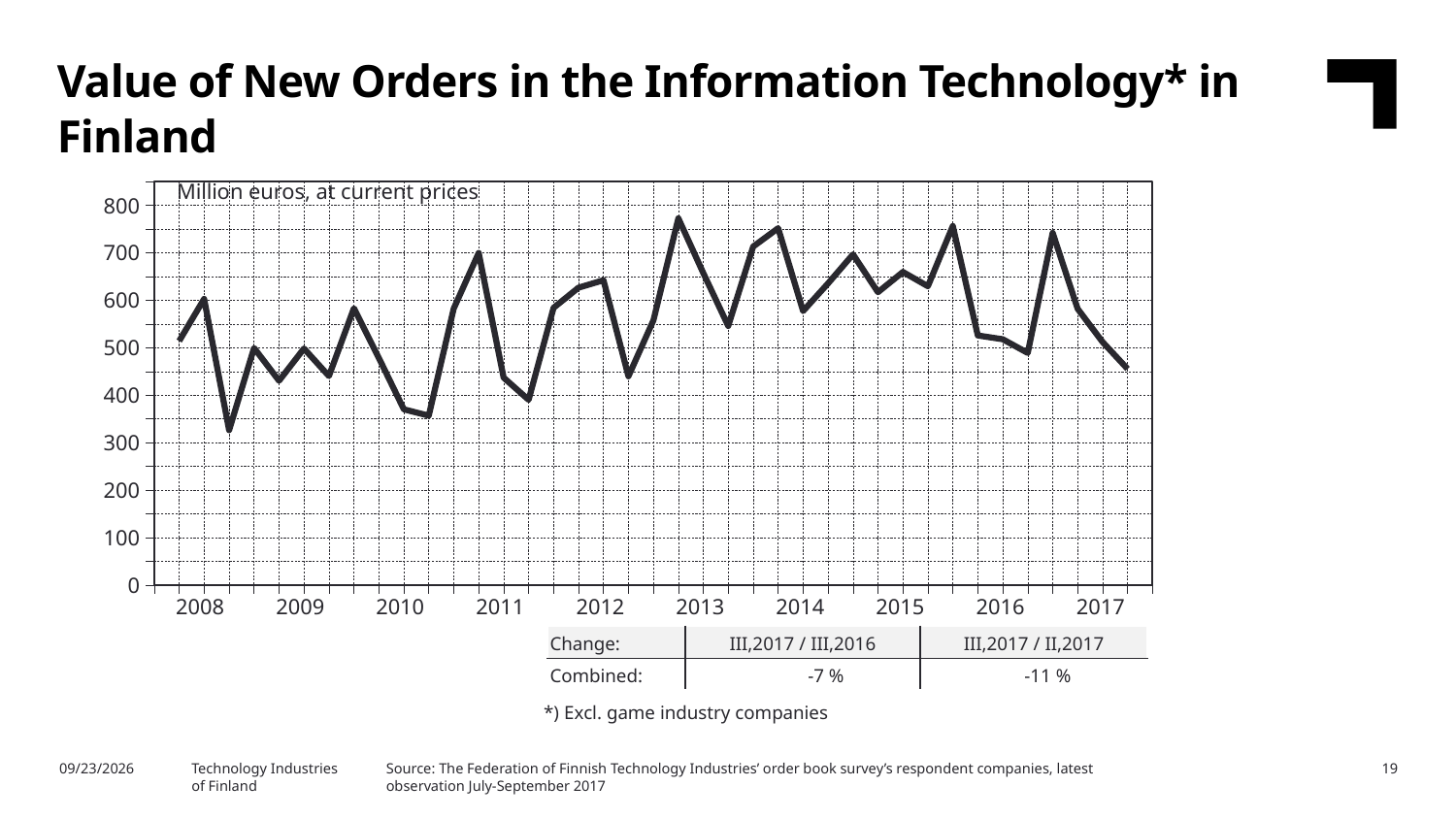
Is the last plotted value in 2017 greater or less than 500? less In what unit are the values on the chart expressed, according to the label inside the plot area? Million euros, at current prices What is the combined change for III,2017 / II,2017 shown below the chart? -11 % How many years are labelled on the x axis of the chart? 10 What is the combined change for III,2017 / III,2016 shown below the chart? -7 % What is the title of the chart on the slide? Value of New Orders in the Information Technology* in Finland What kind of chart is shown on the slide? line chart Is the lowest point of the line in 2008 greater or less than 400? less Is the peak of the line in 2016 greater or less than 700? greater Do the values rise or fall from the peak in 2016 to the end of 2017? fall Is the highest point in 2012 higher or lower than the lowest point in 2008? higher